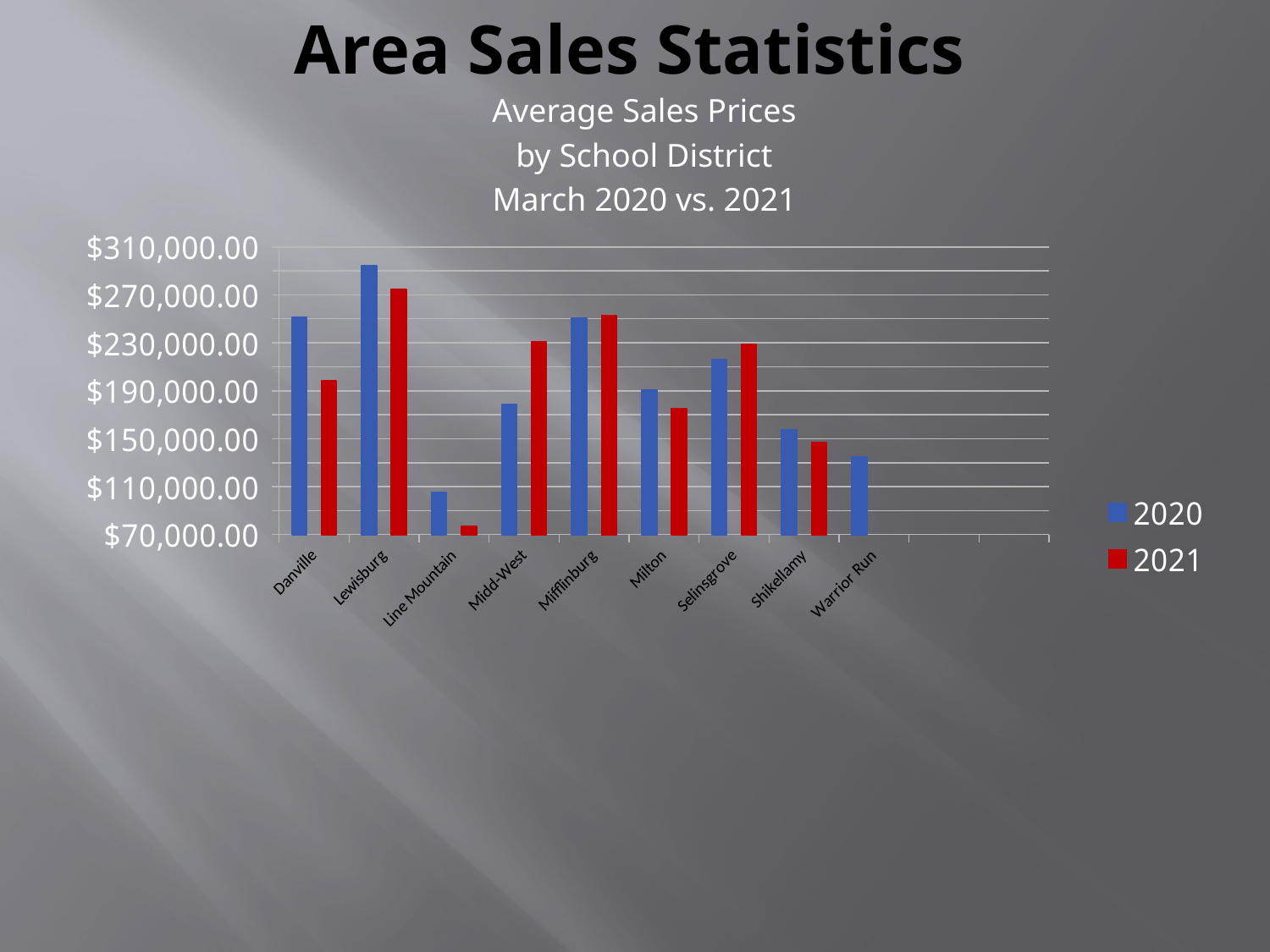
Which school district has the highest 2020 average sales price? Lewisburg What kind of chart is shown on the slide? Bar chart Which school district has the lowest 2021 average sales price? Line Mountain Which school district has the highest 2021 average sales price? Lewisburg For Danville, which year has the higher average sales price, 2020 or 2021? 2020 Which school district has the lowest 2020 average sales price? Line Mountain Is the 2021 value for Line Mountain greater or less than $110,000.00? less Which school district has a bar for 2020 but no bar for 2021? Warrior Run Is the 2020 value for Lewisburg greater or less than $270,000.00? greater How many school districts are shown on the x axis of the chart? 9 How many series does the chart's legend list? 2 For Midd-West, which year has the higher average sales price, 2020 or 2021? 2021